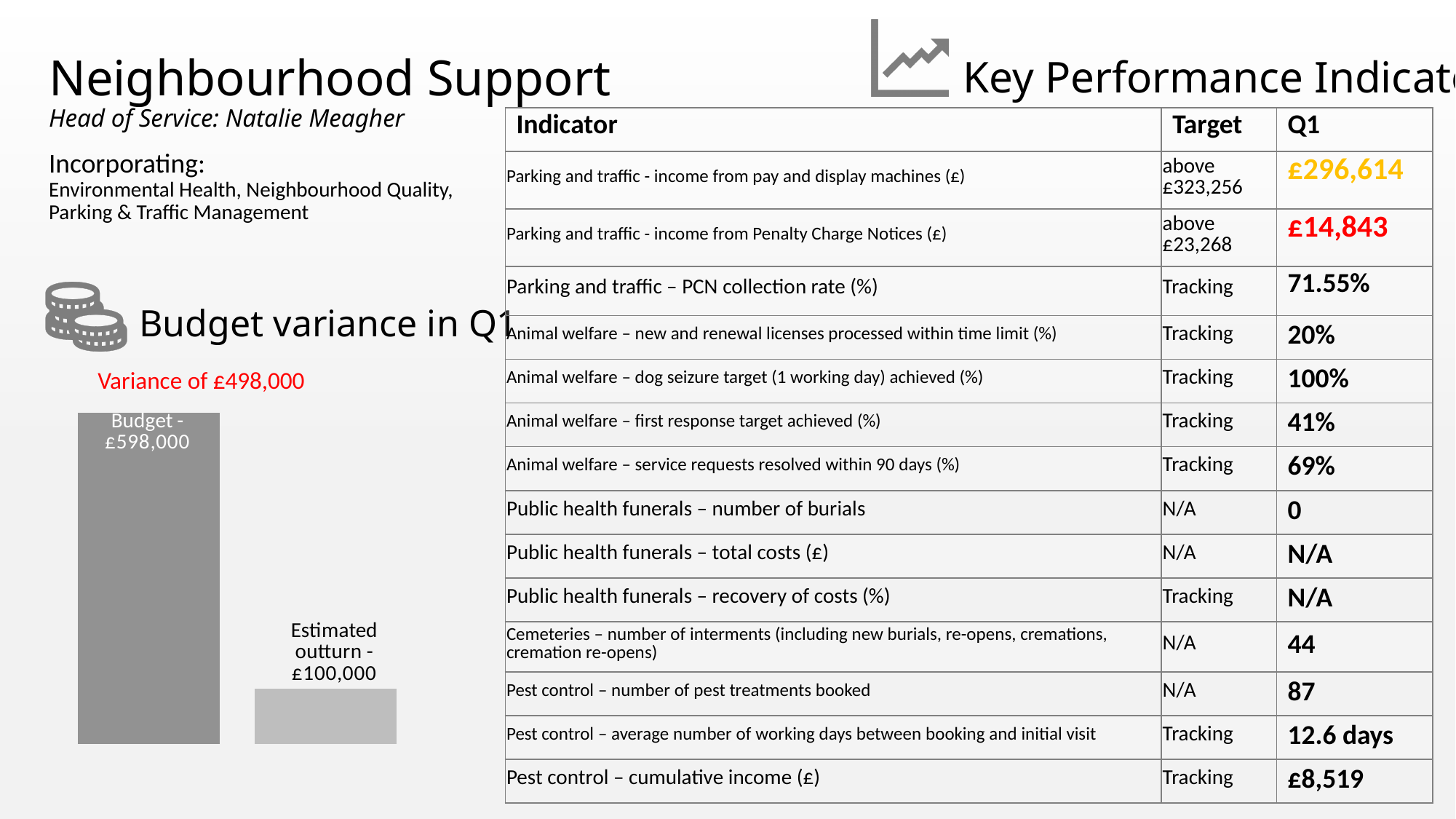
What variance is stated above the budget variance chart? Variance of £498,000 In the budget variance chart, which is larger: the Budget or the Estimated outturn? Budget In the budget variance chart, what is the difference between the Budget and the Estimated outturn? £498,000 What kind of chart is shown under the 'Budget variance in Q1' heading? bar chart In the budget variance chart, what is the value of the Estimated outturn bar? £100,000 In the budget variance chart, what is the value of the Budget bar? £598,000 How many bars are plotted in the budget variance chart? 2 What is the heading of the chart on the left of the slide? Budget variance in Q1 In the budget variance chart, which bar is the lowest? Estimated outturn In the budget variance chart, which bar is the highest? Budget